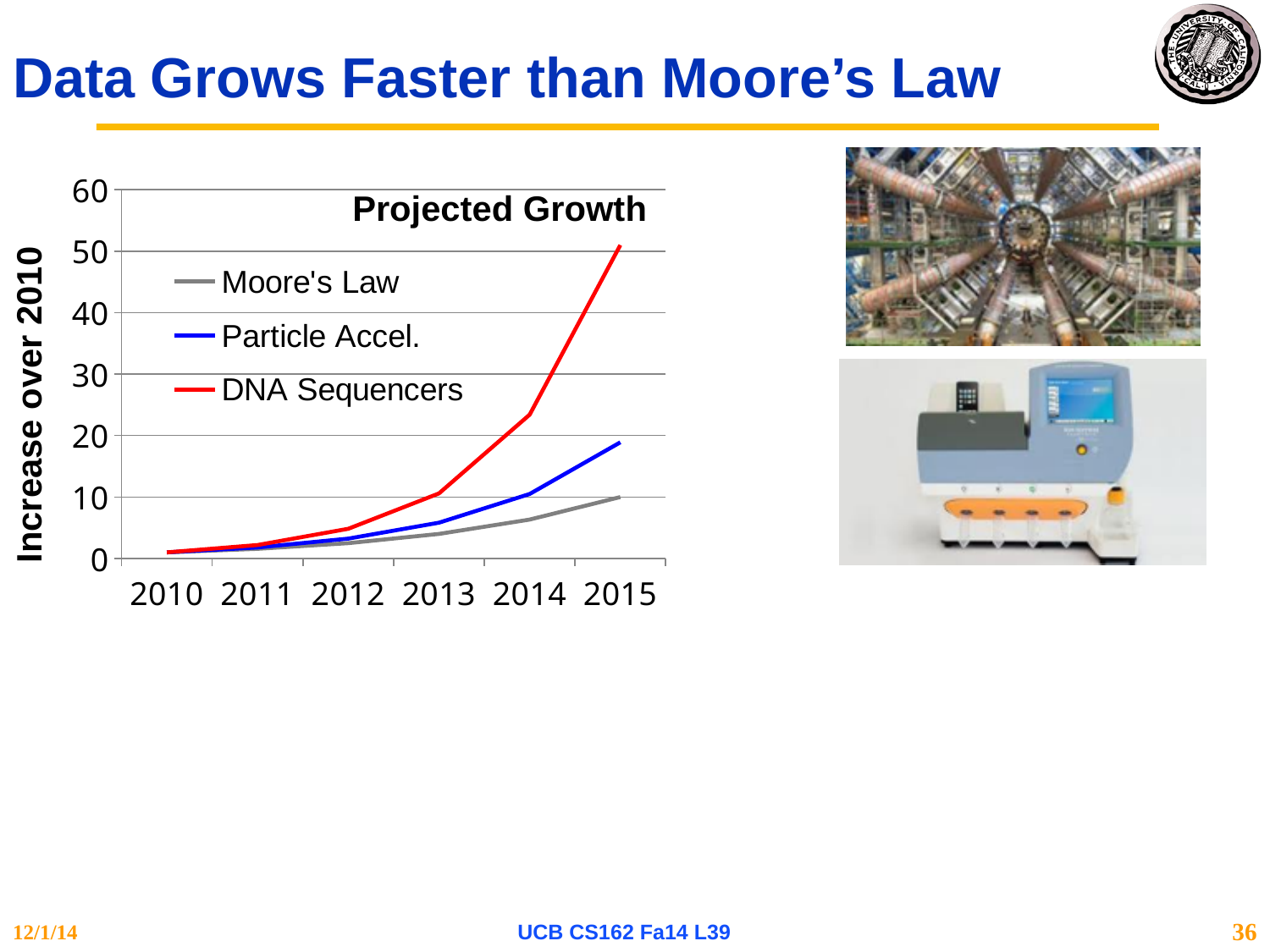
How many years are shown along the x axis of the chart? 6 Is the value for Particle Accel. in 2015 greater or less than 30? less Which series has the highest value in 2015? DNA Sequencers Do the values for DNA Sequencers rise or fall from 2010 to 2015? rise What is the title of the chart? Projected Growth Which series has the lowest value in 2015? Moore's Law What is the label on the chart's vertical axis? Increase over 2010 How many series does the chart's legend list? 3 What kind of chart is shown on the slide? line chart Is the value for DNA Sequencers in 2014 greater or less than 20? greater In 2015, which is larger: the value for Particle Accel. or the value for Moore's Law? Particle Accel. Is the value for DNA Sequencers in 2015 greater or less than 40? greater